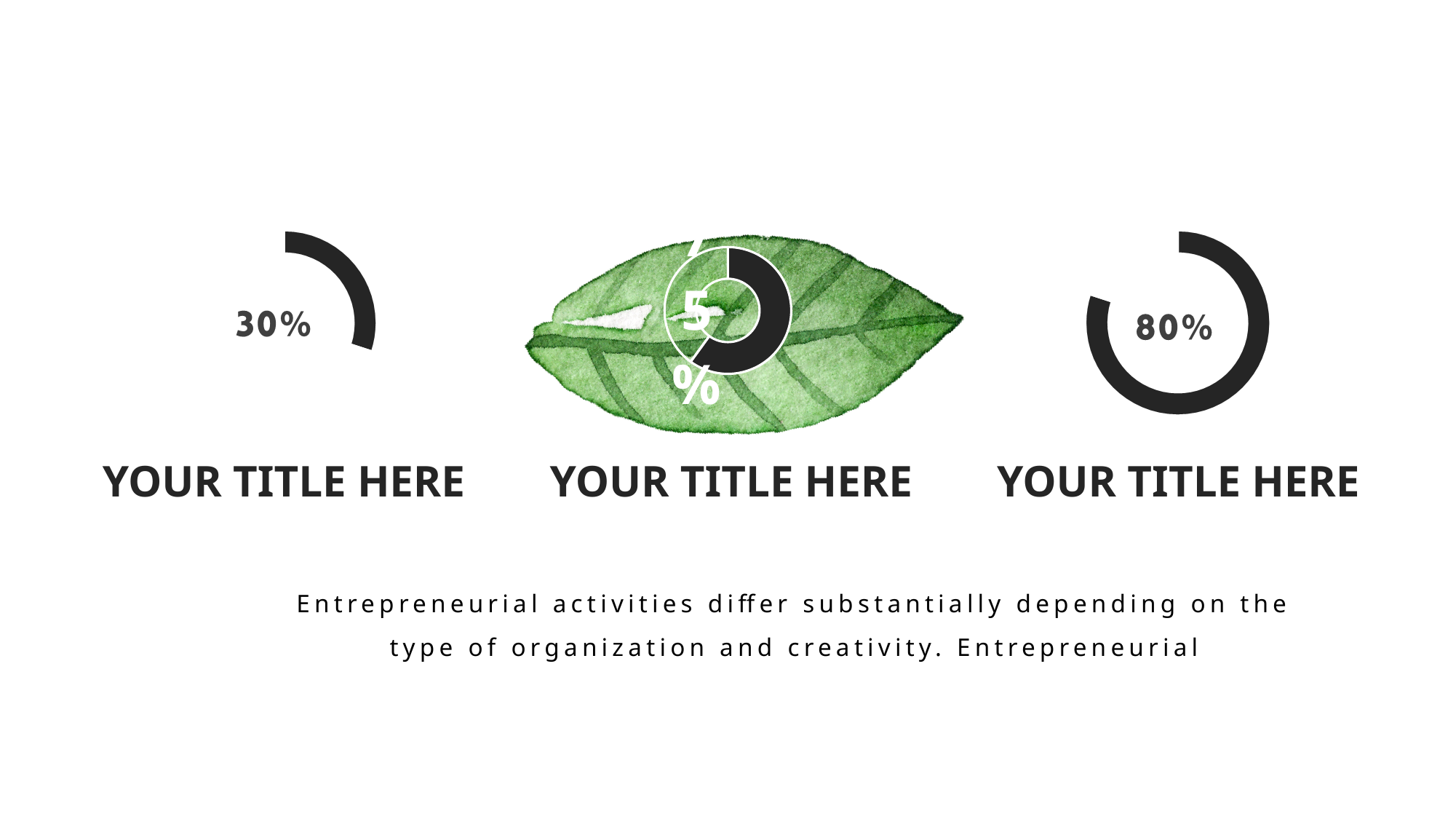
What is the title text shown under each ring chart? YOUR TITLE HERE What image is placed behind the middle ring chart? A green leaf What is the difference between the right ring chart's value and the left ring chart's value? 50 percentage points Which ring chart shows the highest percentage, the left, middle or right one? right What kind of chart is used to display the percentages on the slide? Ring (donut) chart How many ring charts are shown on the slide? 3 Is the value in the left ring chart greater or less than 50%? less What value is shown in the left ring chart? 30% What value is shown in the right ring chart? 80% Which is larger, the value in the left ring chart or the value in the right ring chart? right (80%) Which ring chart shows the lowest percentage, the left, middle or right one? left Is the value in the right ring chart greater or less than 50%? greater